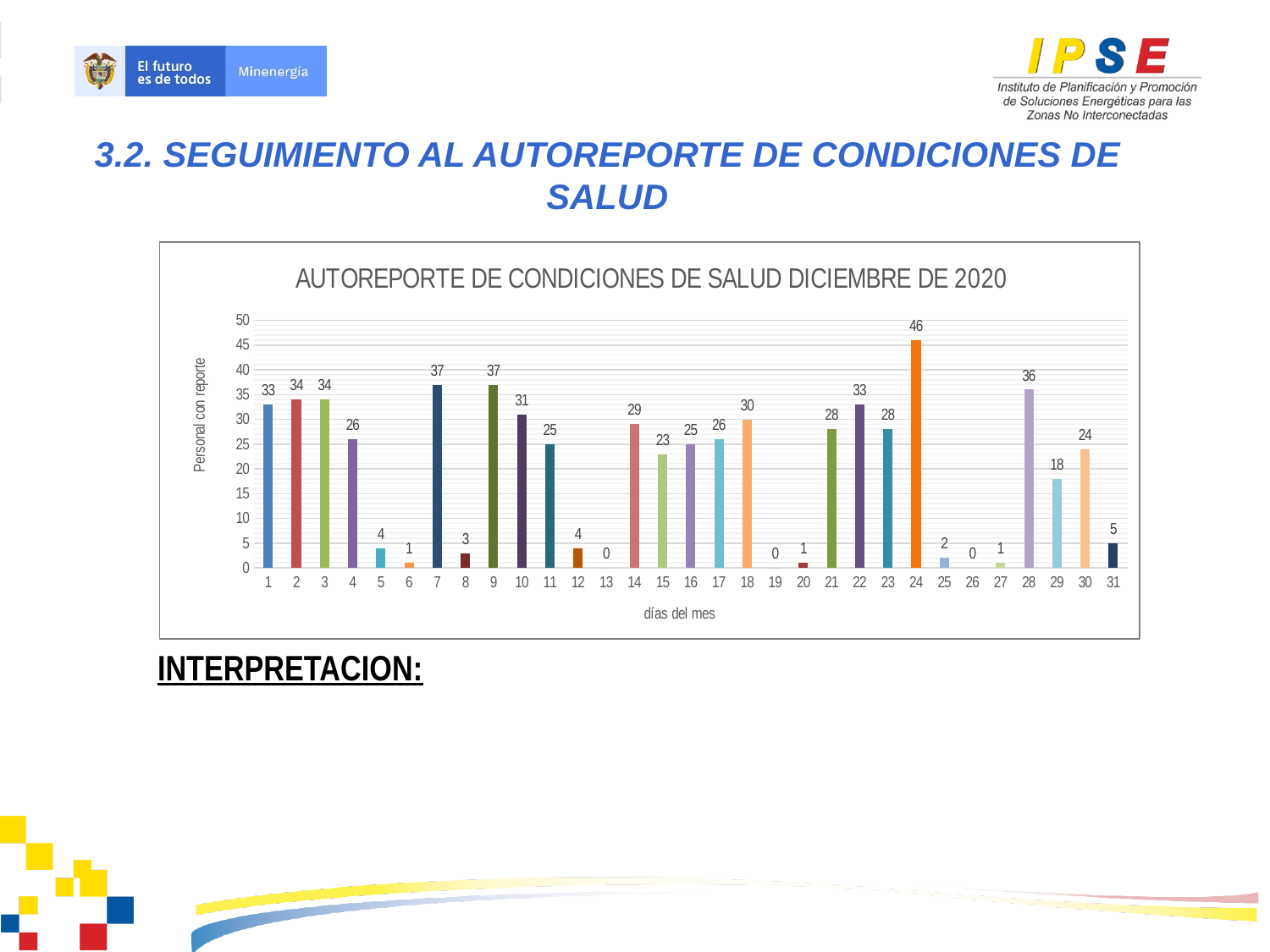
What is the difference between the values for day 1 and day 4? 7 What is the value shown for day 29? 18 How many days of the month are shown on the x axis of the chart? 31 Which has a larger value, day 10 or day 14? day 10 Which has a larger value, day 15 or day 30? day 30 What is the difference between the values for day 24 and day 28? 10 What kind of chart is shown on the slide? bar chart How many people reported on day 7 according to the chart? 37 Which day of the month has the highest value in the chart? 24 What is the title of the chart? AUTOREPORTE DE CONDICIONES DE SALUD DICIEMBRE DE 2020 What is the lowest value shown in the chart? 0 What is the value for day 24 in the chart? 46